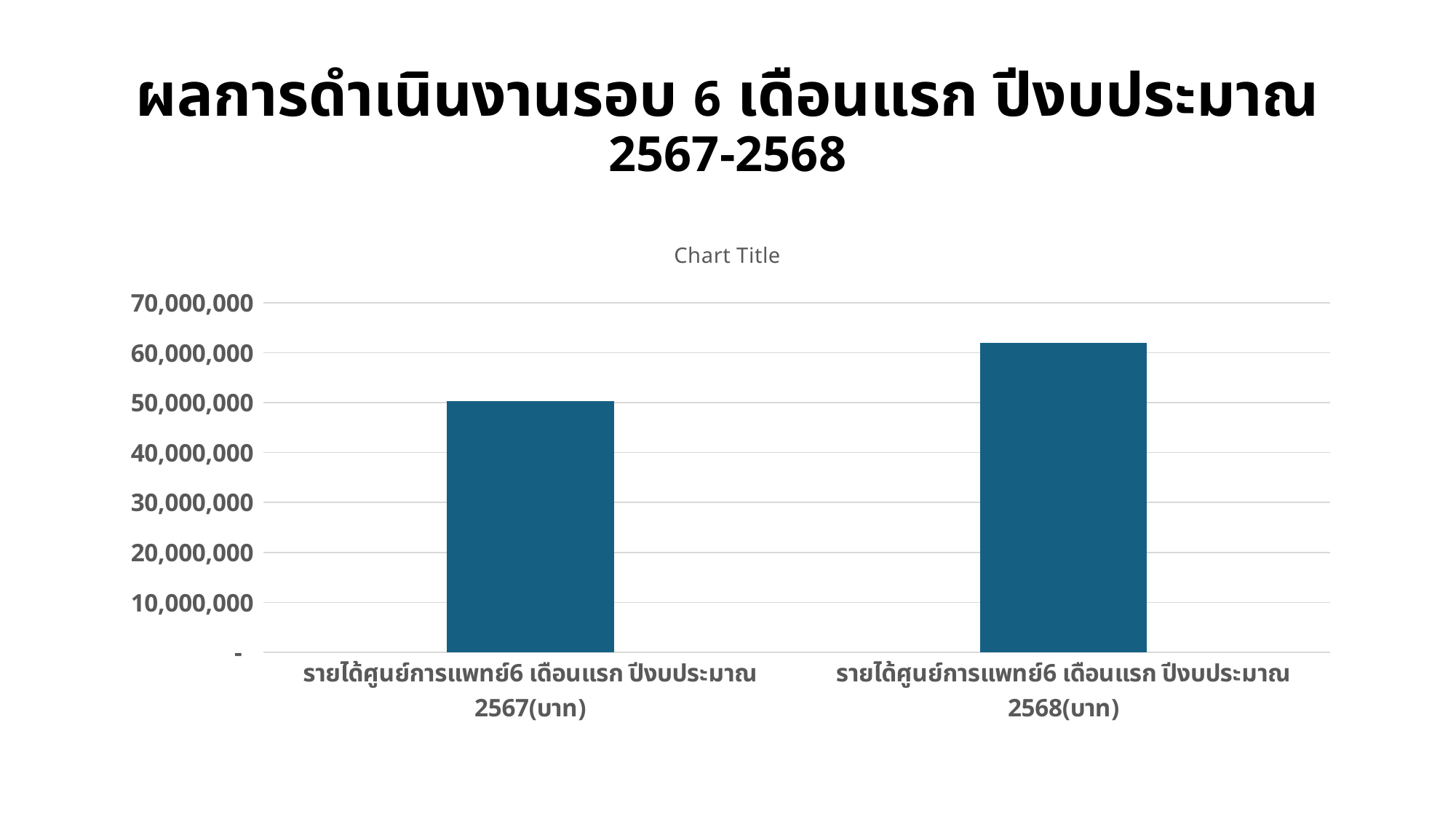
How many bars (categories) does the chart show? 2 What kind of chart is shown on the slide? bar chart Which category has the higher bar: รายได้ศูนย์การแพทย์6 เดือนแรก ปีงบประมาณ 2567(บาท) or รายได้ศูนย์การแพทย์6 เดือนแรก ปีงบประมาณ 2568(บาท)? รายได้ศูนย์การแพทย์6 เดือนแรก ปีงบประมาณ 2568(บาท) Is the bar for ปีงบประมาณ 2568 larger or smaller than the bar for ปีงบประมาณ 2567? larger What is the title printed above the chart? Chart Title Do the values rise or fall from the 2567 bar to the 2568 bar? rise Which category has the lowest bar in the chart? รายได้ศูนย์การแพทย์6 เดือนแรก ปีงบประมาณ 2567(บาท) Is the value for รายได้ศูนย์การแพทย์6 เดือนแรก ปีงบประมาณ 2567(บาท) greater or less than 60,000,000? less Is the value for รายได้ศูนย์การแพทย์6 เดือนแรก ปีงบประมาณ 2568(บาท) greater or less than 50,000,000? greater Is the value for รายได้ศูนย์การแพทย์6 เดือนแรก ปีงบประมาณ 2567(บาท) greater or less than 40,000,000? greater What is the highest value shown on the vertical axis? 70,000,000